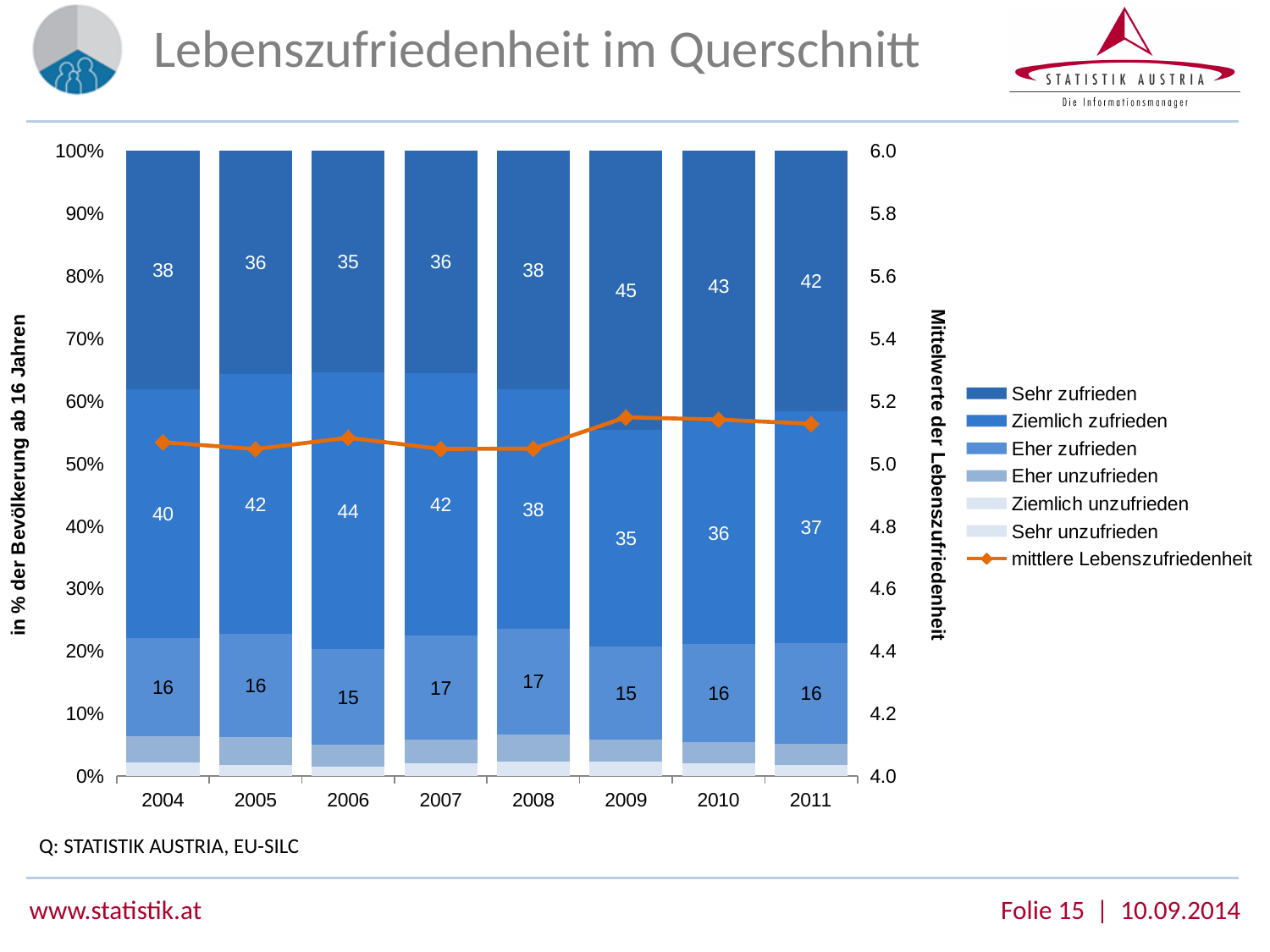
In which year is the value for "Sehr zufrieden" highest? 2009 What colour is the line for "mittlere Lebenszufriedenheit"? orange What is the value for "Eher zufrieden" in 2008? 17 In 2011, which is larger: the value for "Sehr zufrieden" or the value for "Ziemlich zufrieden"? Sehr zufrieden How many series does the legend of the chart list? 7 In which year is the value for "Ziemlich zufrieden" lowest? 2009 What is the value for "Sehr zufrieden" in 2009? 45 Is the value of "mittlere Lebenszufriedenheit" for 2005 greater or less than 5.0? greater What is the difference between the "Sehr zufrieden" values for 2009 and 2004? 7 What is the value for "Ziemlich zufrieden" in 2006? 44 What kind of chart is shown on the slide? combination bar and line chart How many years are shown along the x axis of the chart? 8